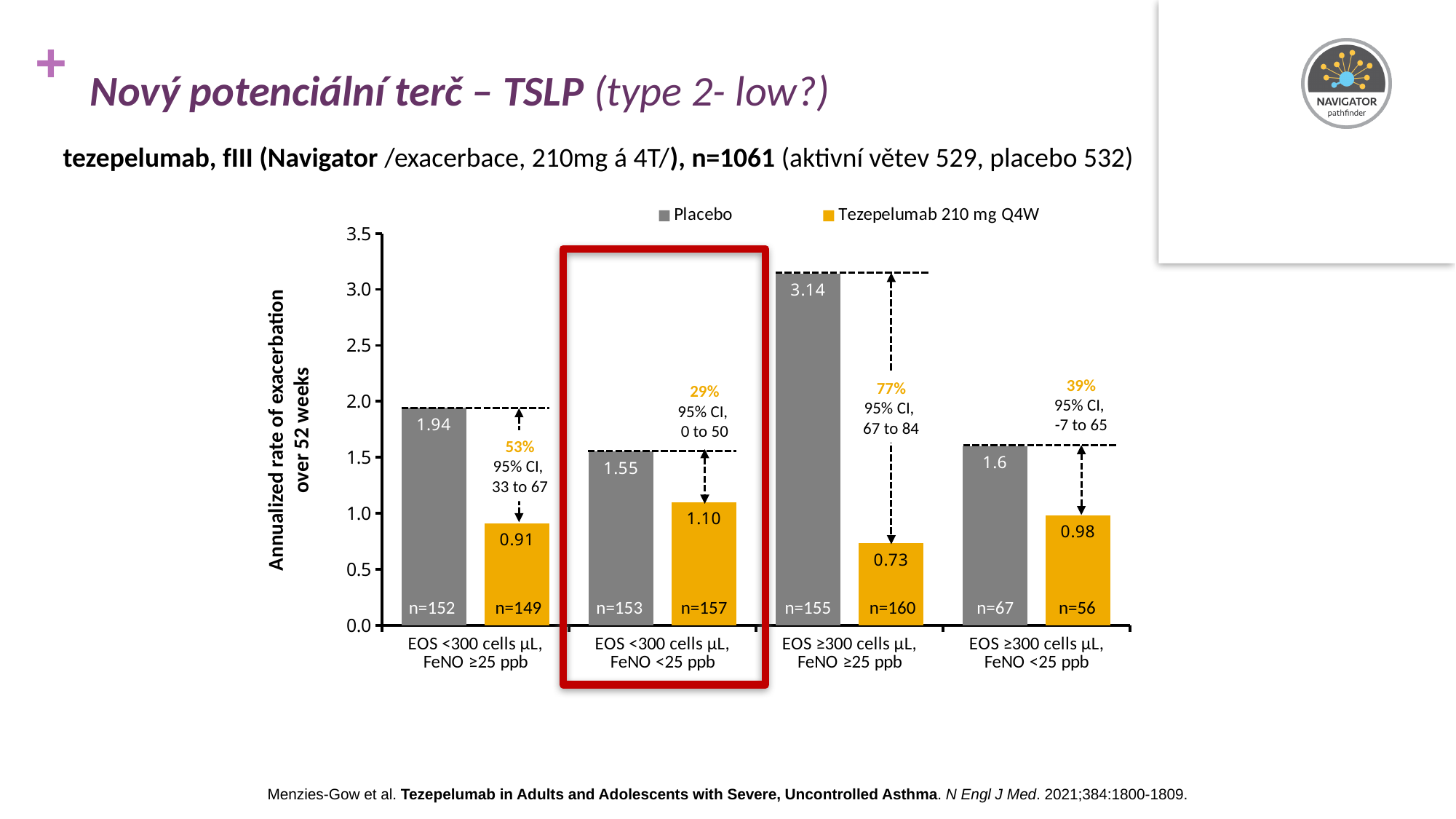
Which subgroup has the highest Placebo exacerbation rate? EOS ≥300 cells µL, FeNO ≥25 ppb What percentage reduction is shown for the EOS ≥300 cells µL, FeNO ≥25 ppb group? 77% What is the annualized exacerbation rate for Tezepelumab 210 mg Q4W in the EOS <300 cells µL, FeNO <25 ppb group? 1.10 What is the annualized exacerbation rate for Tezepelumab 210 mg Q4W in the EOS ≥300 cells µL, FeNO <25 ppb group? 0.98 What is the difference between the Placebo and Tezepelumab exacerbation rates in the EOS ≥300 cells µL, FeNO ≥25 ppb group? 2.41 Which subgroup has the lowest Tezepelumab 210 mg Q4W exacerbation rate? EOS ≥300 cells µL, FeNO ≥25 ppb How many series does the legend list? 2 How many subgroup categories are shown on the x axis? 4 What is the annualized exacerbation rate for Placebo in the EOS ≥300 cells µL, FeNO ≥25 ppb group? 3.14 Which is larger: the Tezepelumab rate in the EOS <300 cells µL, FeNO <25 ppb group or in the EOS <300 cells µL, FeNO ≥25 ppb group? EOS <300 cells µL, FeNO <25 ppb Is the Placebo value for the EOS ≥300 cells µL, FeNO ≥25 ppb group greater or less than 3.0? greater What is the annualized exacerbation rate for Placebo in the EOS <300 cells µL, FeNO ≥25 ppb group? 1.94